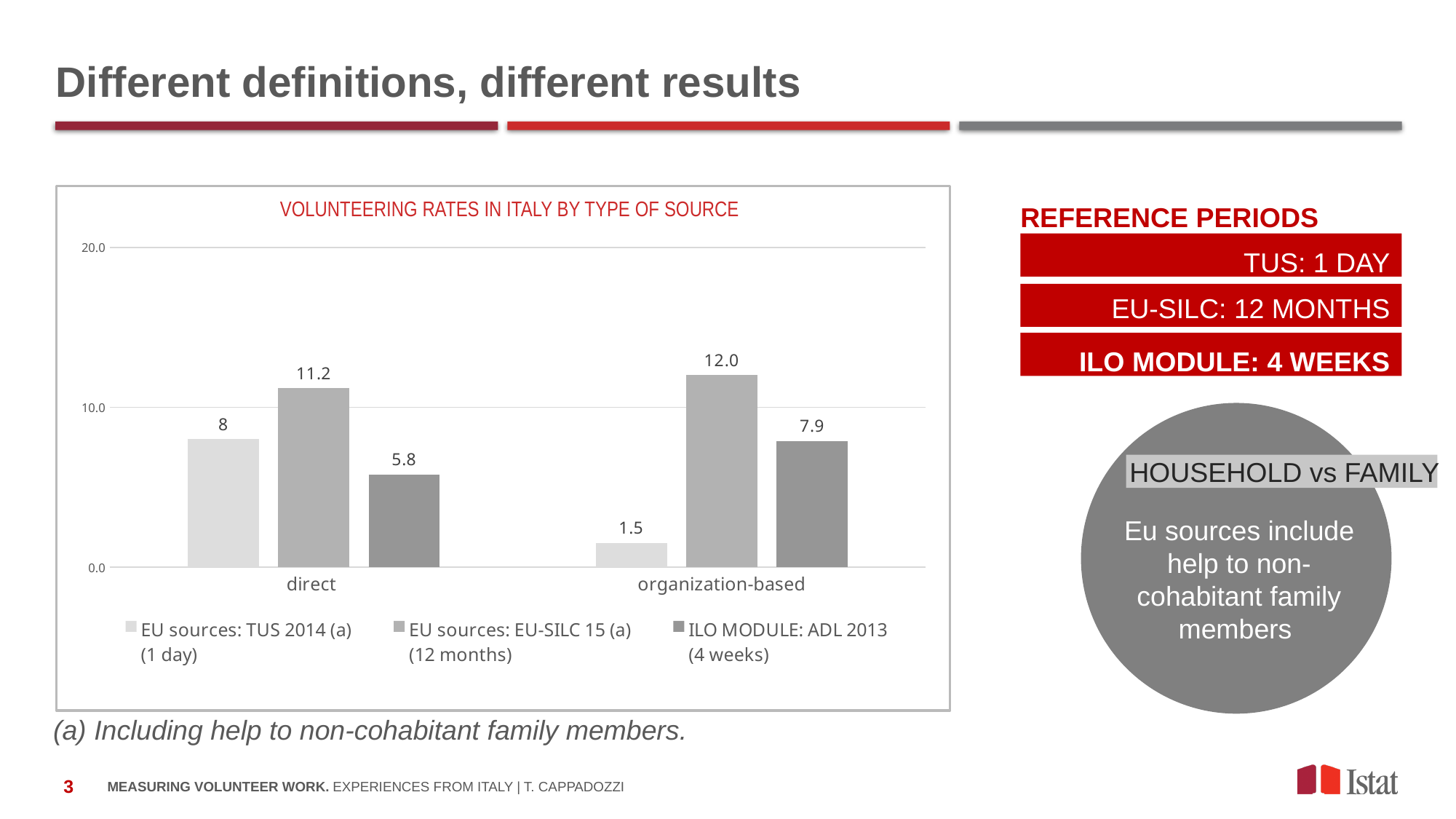
What is the value for direct volunteering in the ILO MODULE: ADL 2013 (4 weeks) series? 5.8 How many series does the legend list? 3 What is the title of the chart? VOLUNTEERING RATES IN ITALY BY TYPE OF SOURCE What is the value for organization-based volunteering in the EU sources: TUS 2014 (1 day) series? 1.5 Which source reports the highest rate for organization-based volunteering? EU sources: EU-SILC 15 (12 months) What is the difference between the EU-SILC 15 and ILO MODULE values for organization-based volunteering? 4.1 What kind of chart is shown on the slide? Bar chart What is the volunteering rate for the direct category from EU sources: TUS 2014 (1 day)? 8 Which source reports the lowest rate for direct volunteering? ILO MODULE: ADL 2013 (4 weeks) How many categories are shown on the x axis? 2 Which is larger: the TUS 2014 value for direct volunteering or the ILO MODULE value for direct volunteering? TUS 2014 value for direct volunteering What is the volunteering rate for organization-based volunteering from EU sources: EU-SILC 15 (12 months)? 12.0